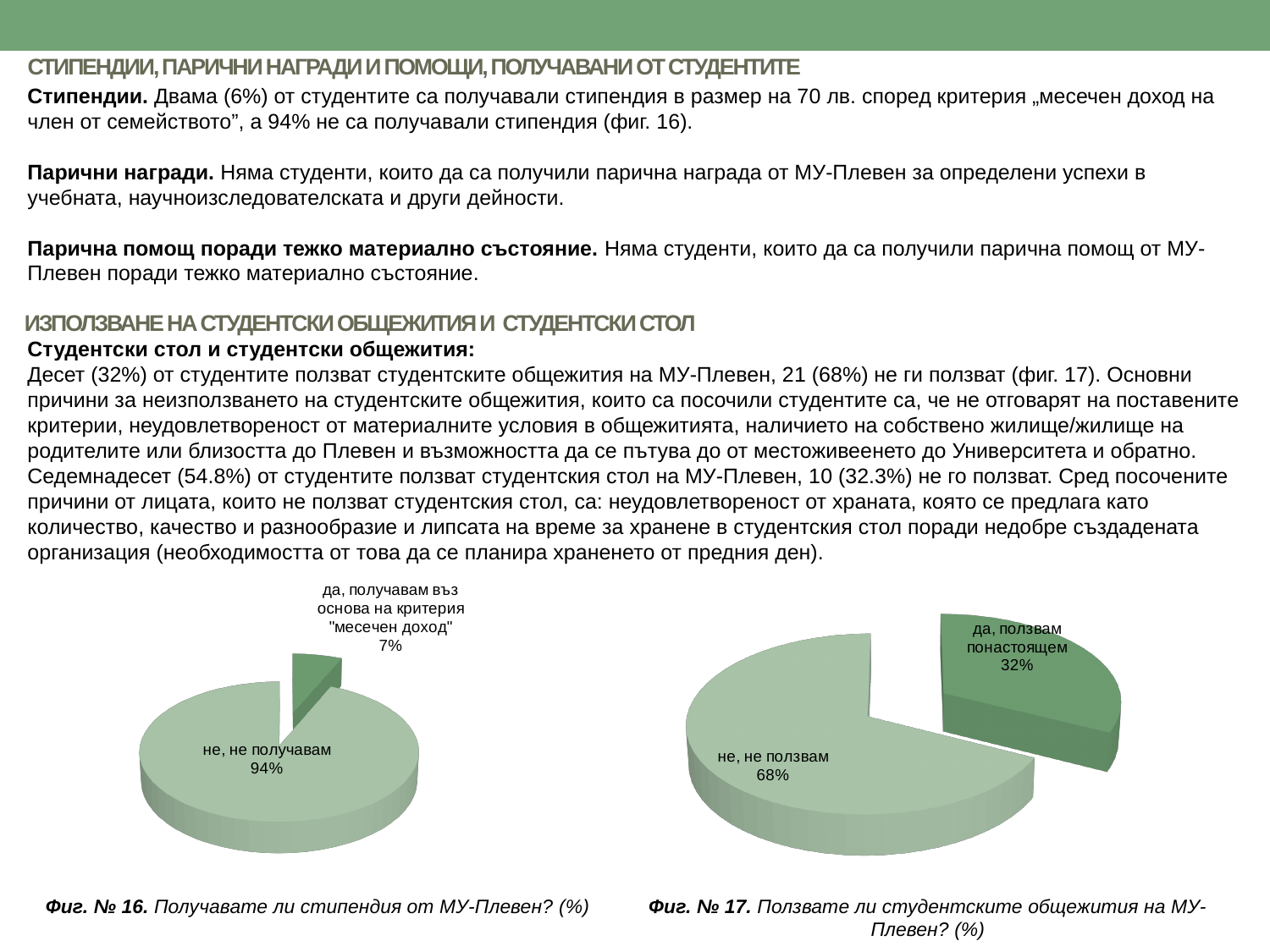
In the left chart (Фиг. № 16), which slice is the smallest? да, получавам въз основа на критерия "месечен доход" What is the caption of the right chart? Фиг. № 17. Ползвате ли студентските общежития на МУ-Плевен? (%) In the right chart (Фиг. № 17), which slice is the largest? не, не ползвам How many slices does the left chart (Фиг. № 16) have? 2 In the left chart (Фиг. № 16), what percentage is shown for the slice "да, получавам въз основа на критерия "месечен доход""? 7% In the right chart (Фиг. № 17), what is the difference in percentage points between "не, не ползвам" and "да, ползвам понастоящем"? 36 In the left chart (Фиг. № 16), which is larger: "не, не получавам" or "да, получавам въз основа на критерия "месечен доход""? не, не получавам In the right chart (Фиг. № 17), what percentage is shown for "да, ползвам понастоящем"? 32% What type of chart is Фиг. № 17? Pie chart How many charts are shown on the slide? 2 In the left chart (Фиг. № 16), what share of the pie is labelled "не, не получавам"? 94% In the right chart (Фиг. № 17), what percentage is shown for "не, не ползвам"? 68%